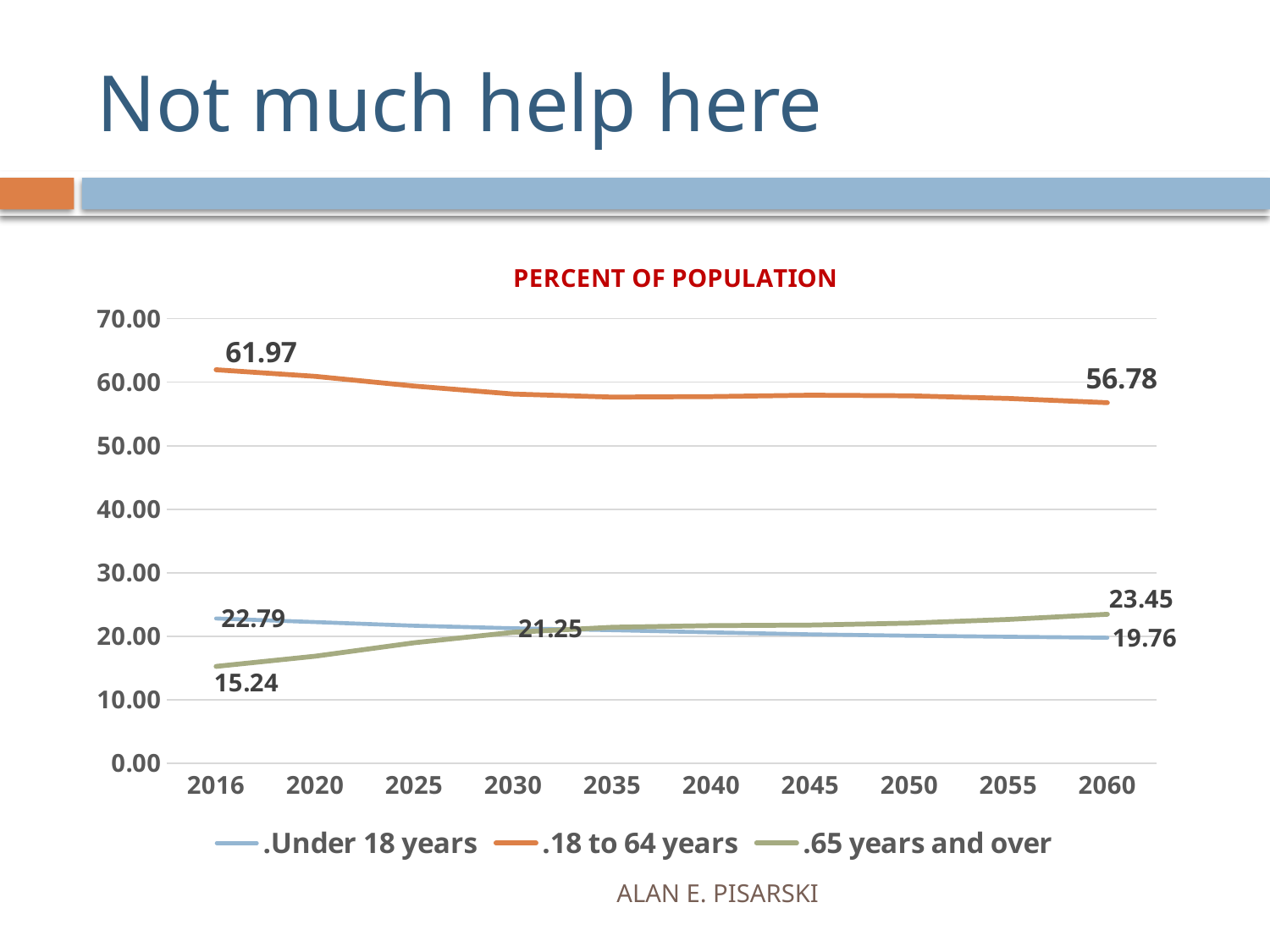
Does the .18 to 64 years line rise or fall from 2016 to 2060? fall What is the value for .Under 18 years in 2016? 22.79 Is the value for .18 to 64 years in 2040 greater or less than 50.00? greater What is the value for .18 to 64 years in 2060? 56.78 By how much does the .65 years and over value rise from 2016 to 2060? 8.21 What kind of chart is shown? line chart Does the .65 years and over line rise or fall from 2016 to 2060? rise By how much does the .18 to 64 years value fall from 2016 to 2060? 5.19 What is the value for .18 to 64 years in 2016? 61.97 In 2060, which is larger: .65 years and over or .Under 18 years? .65 years and over How many series does the legend list? 3 What is the value for .65 years and over in 2060? 23.45